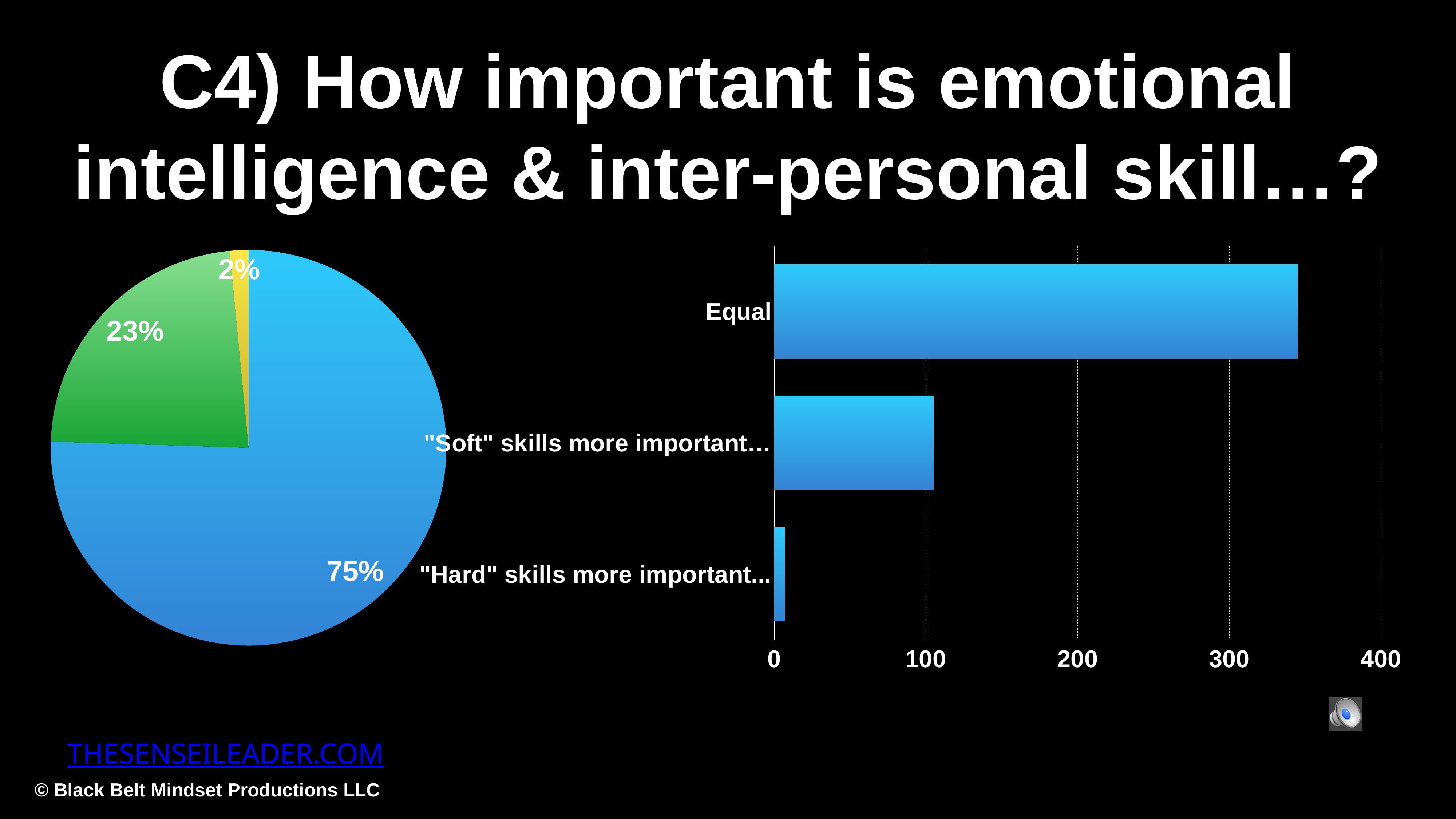
In the bar chart on the right, which category has the longest bar? Equal How many slices does the pie chart on the left have? 3 In the bar chart on the right, which is larger: the value for Equal or the value for "Soft" skills more important...? Equal In the bar chart on the right, is the value for Equal greater or less than 300? greater How many categories does the bar chart on the right show? 3 In the bar chart on the right, is the value for "Hard" skills more important... greater or less than 100? less In the bar chart on the right, which category has the shortest bar? "Hard" skills more important... In the pie chart on the left, what is the value of the largest slice? 75% What kind of chart is the chart on the right of the slide? bar chart What kind of chart is the chart on the left of the slide? pie chart In the pie chart on the left, what is the difference between the largest slice and the second-largest slice? 52% In the pie chart on the left, what is the value of the smallest slice? 2%